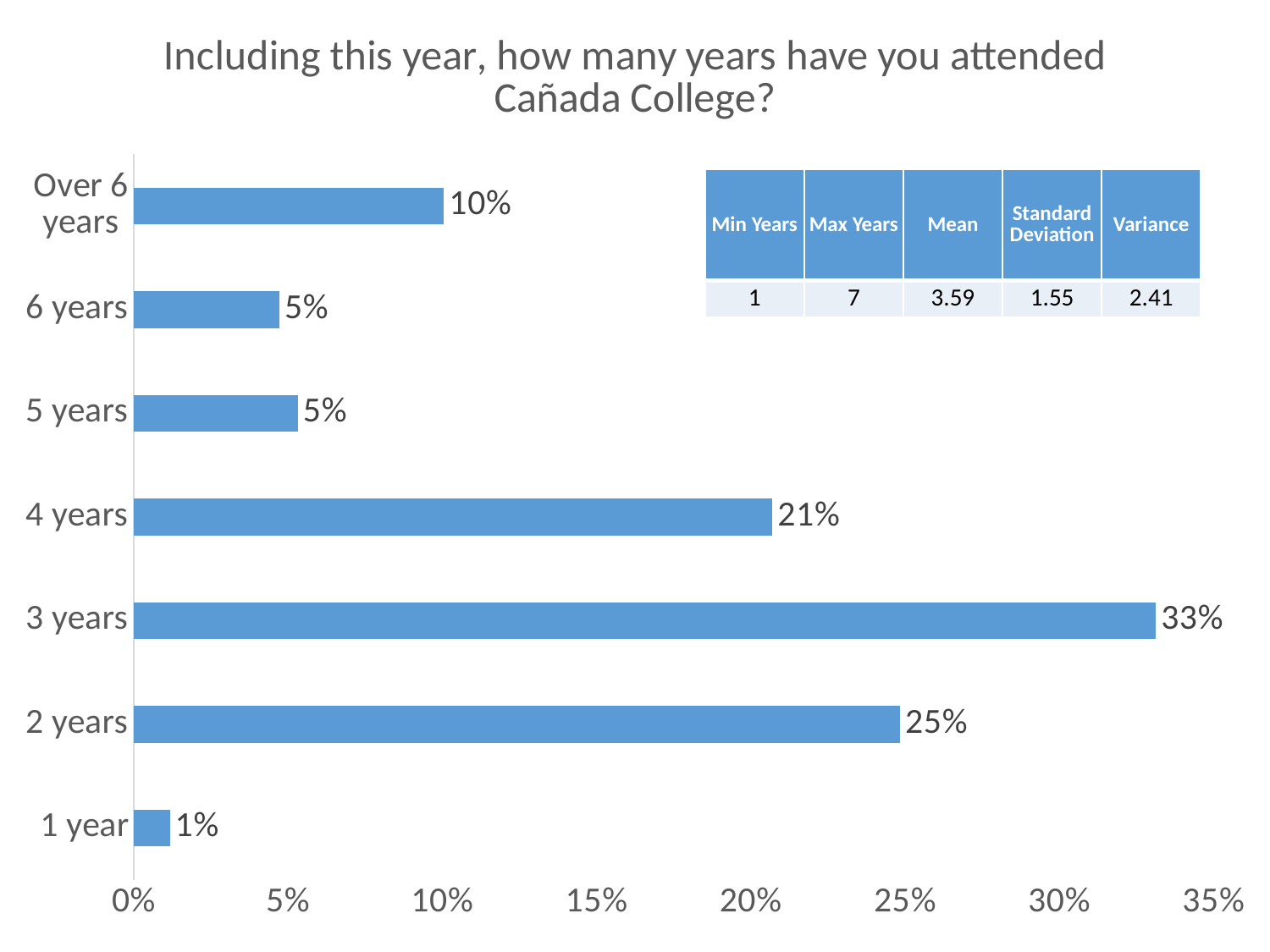
What percentage of respondents have attended Cañada College for 3 years? 33% How many categories are shown on the chart? 7 Is the value for 2 years greater or less than 20%? greater What percentage of respondents have attended for over 6 years? 10% What kind of chart is shown on the slide? bar chart What is the mean number of years shown in the table on the slide? 3.59 Which category has the highest percentage of respondents? 3 years Which category has a larger share of respondents, 4 years or over 6 years? 4 years What is the difference in percentage points between the 3 years and 2 years categories? 8% Which category has the lowest percentage of respondents? 1 year What is the title of the chart? Including this year, how many years have you attended Cañada College? What percentage of respondents have attended for 1 year? 1%